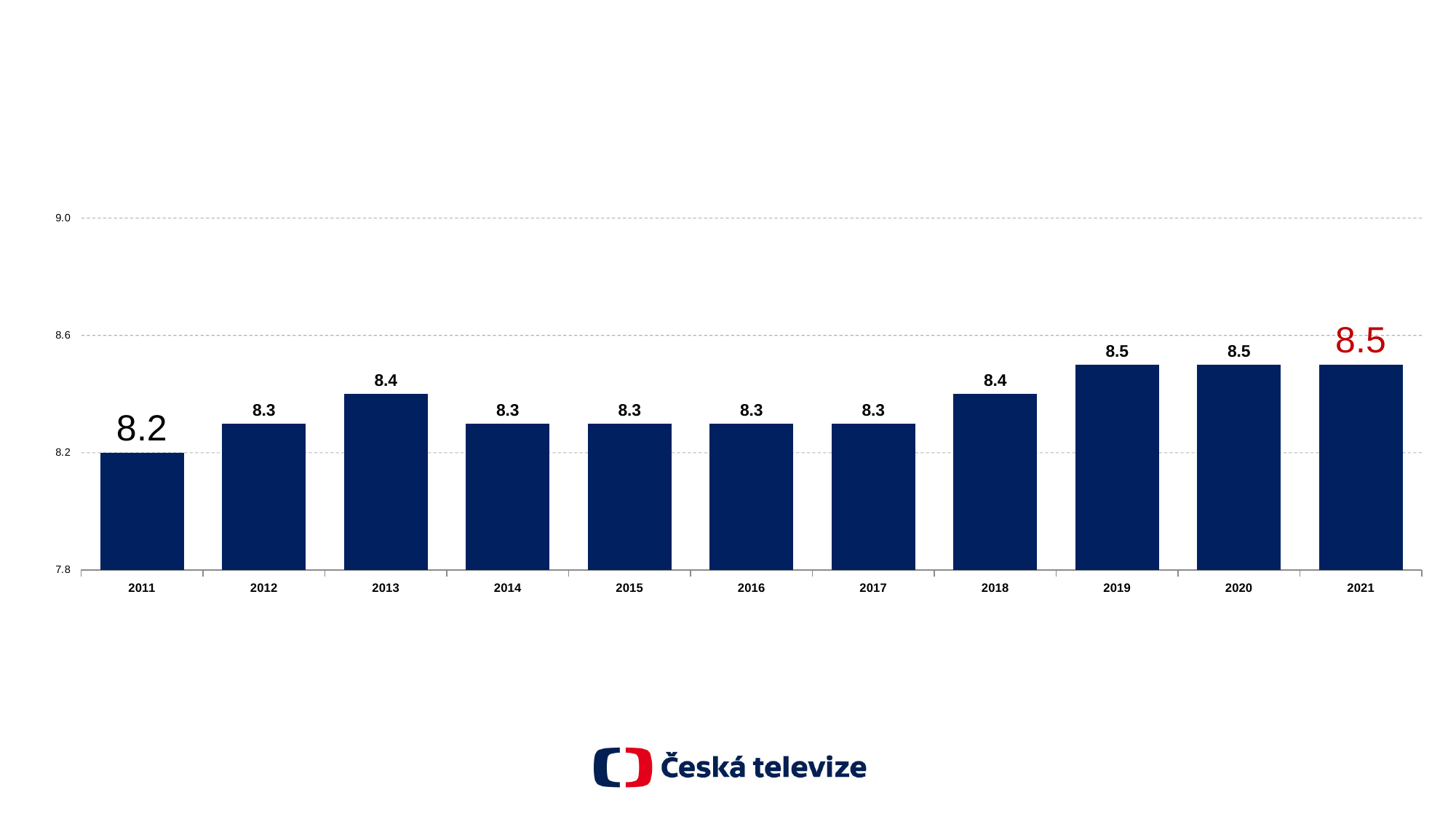
Which is larger, the value for 2013 or the value for 2014? 2013 What kind of chart is this? bar chart Which year has the lowest value? 2011 How many years are shown on the x axis? 11 Is the value for 2019 greater or less than 8.6? less What is the difference between the values for 2018 and 2012? 0.1 What is the value for 2011? 8.2 What is the value for 2017? 8.3 What is the difference between the values for 2021 and 2011? 0.3 What is the value for 2021? 8.5 Do the values generally rise or fall from 2011 to 2021? rise What is the value for 2013? 8.4